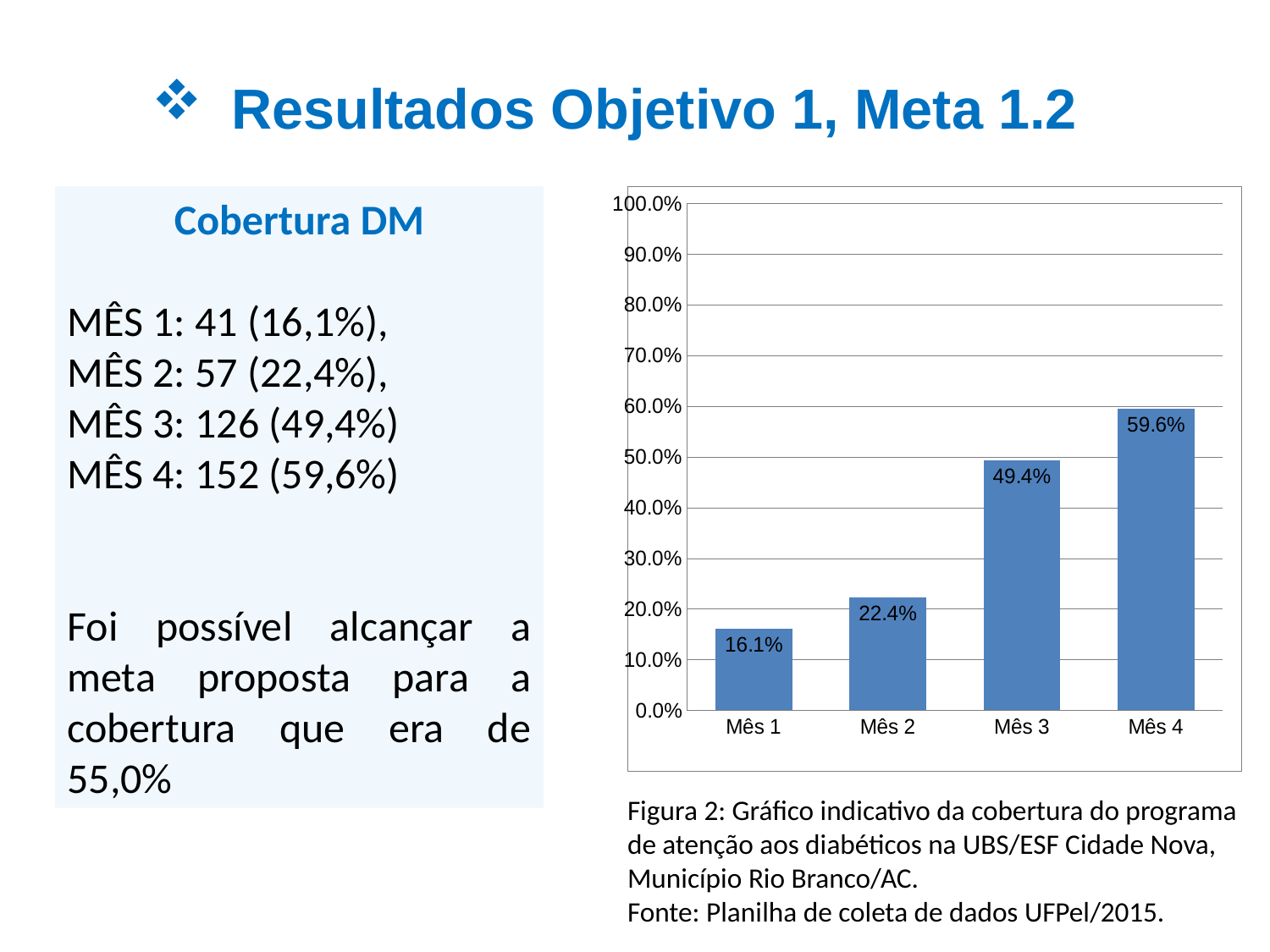
Is the value for Mês 4 greater or less than 50.0%? greater What is the difference between the values for Mês 4 and Mês 1? 43.5% Do the values rise or fall from Mês 1 to Mês 4? rise What is the value for Mês 3? 49.4% What is the value for Mês 1? 16.1% What kind of chart is shown? bar chart Which is larger, the value for Mês 2 or the value for Mês 3? Mês 3 Which month has the lowest value? Mês 1 Which month has the highest value? Mês 4 What is the value for Mês 4? 59.6% What is the difference between the values for Mês 3 and Mês 2? 27.0% How many months are shown on the x axis? 4